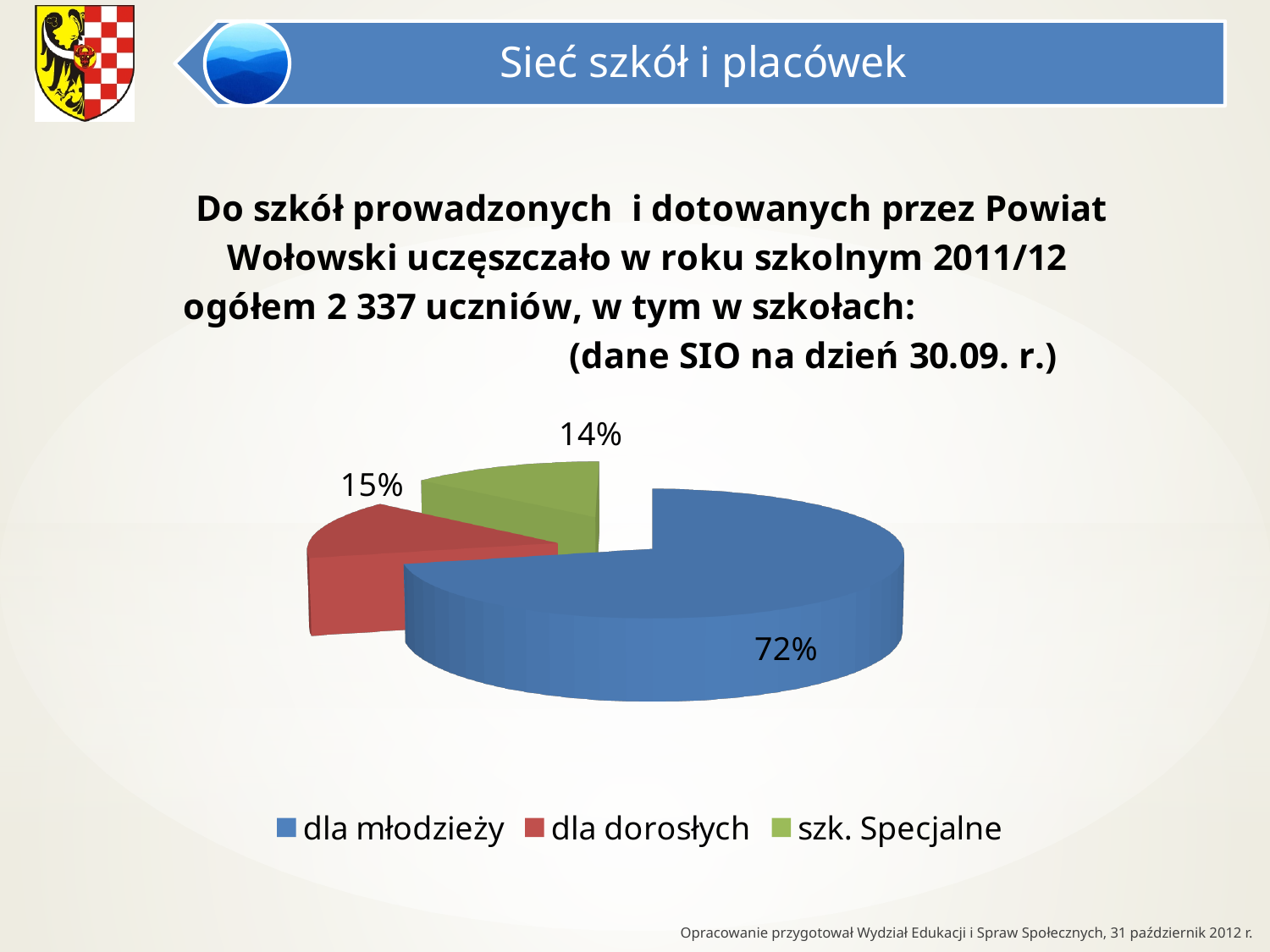
How many categories does the pie chart show? 3 What share of the pie does "dla młodzieży" represent? 72% Which legend entry is shown in green? szk. Specjalne Which is larger, the share for "dla młodzieży" or for "szk. Specjalne"? dla młodzieży What share of the pie does "szk. Specjalne" represent? 14% What colour is the slice for "dla dorosłych"? red What is the difference in percentage points between "dla młodzieży" and "dla dorosłych"? 57 What share of the pie does "dla dorosłych" represent? 15% What kind of chart is shown on the slide? pie chart Which category has the largest slice of the pie? dla młodzieży Which category has the smallest slice of the pie? szk. Specjalne